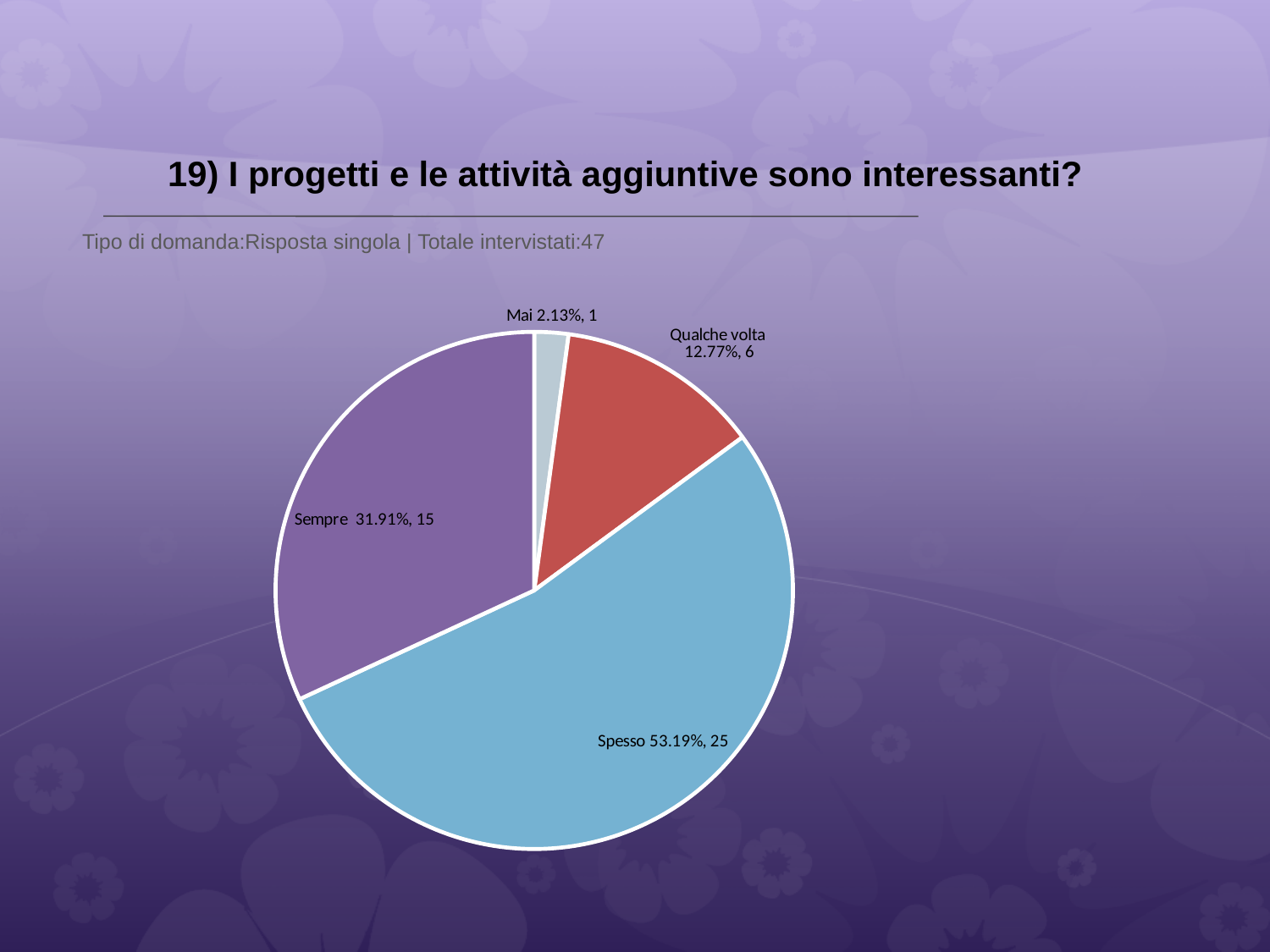
What is the total number of respondents shown in the pie chart? 47 What percentage share does the 'Spesso' slice have? 53.19% What percentage share does the 'Qualche volta' slice have? 12.77% What kind of chart is shown on the slide? pie chart Which category has the smallest slice of the pie? Mai How many respondents answered 'Sempre'? 15 What is the difference in respondent count between 'Spesso' and 'Sempre'? 10 Which has more respondents, 'Qualche volta' or 'Sempre'? Sempre How many respondents answered 'Mai'? 1 What colour is the 'Spesso' slice? light blue Which category has the largest slice of the pie? Spesso How many slices does the pie chart have? 4